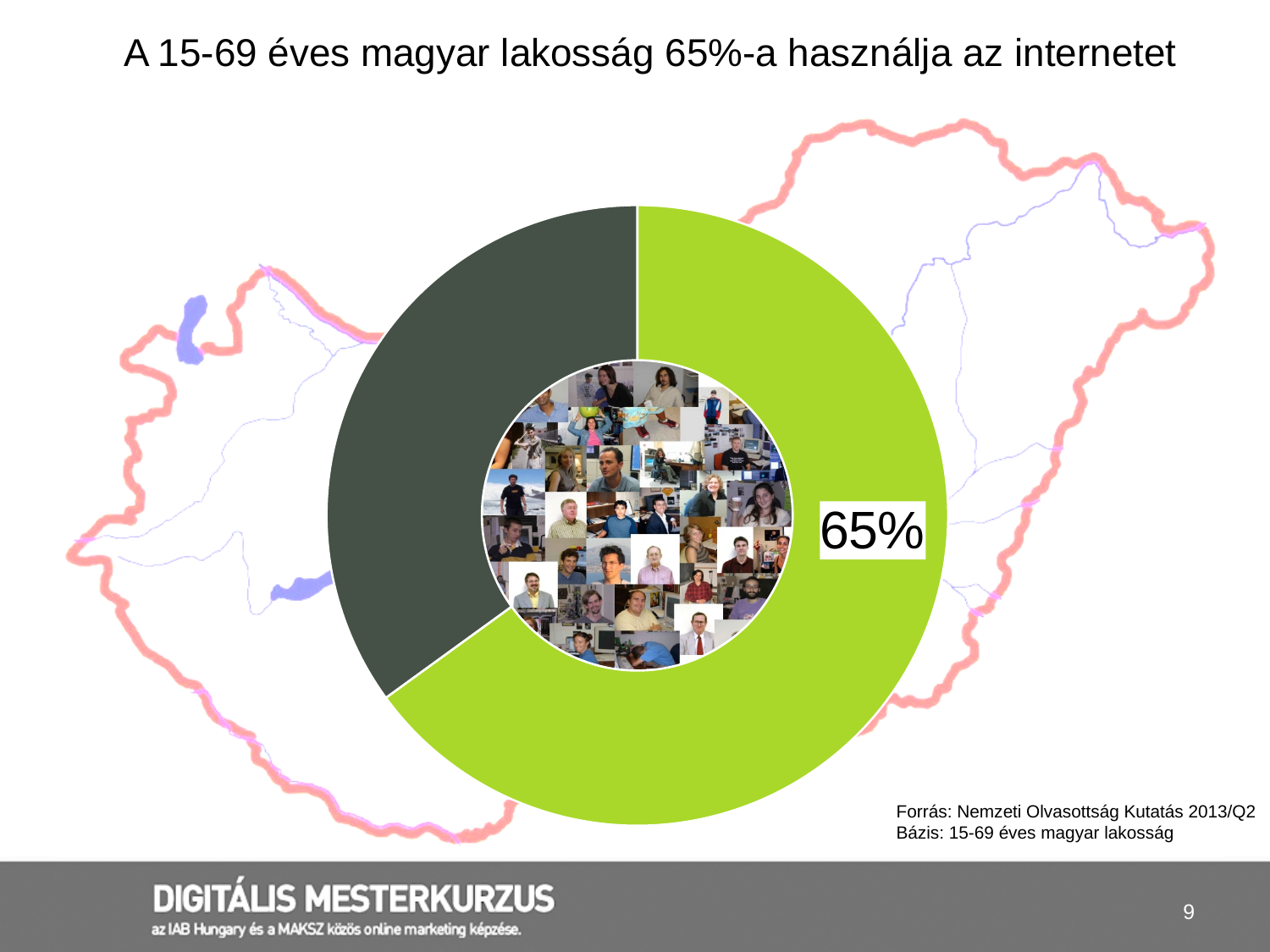
How many slices does the chart have? 2 According to the slide title, what percentage of the Hungarian population aged 15-69 uses the internet? 65% What kind of chart is shown on the slide? pie (donut) chart What source (Forrás) is cited for the chart data? Nemzeti Olvasottság Kutatás 2013/Q2 Which slice of the chart is the largest? the green slice (65%) What percentage is printed on the green slice of the chart? 65% What is the title of the slide? A 15-69 éves magyar lakosság 65%-a használja az internetet Which slice of the chart is the smallest? the dark grey slice What share of the pie does the green slice represent? 65% Which slice is larger, the green one or the dark grey one? the green one